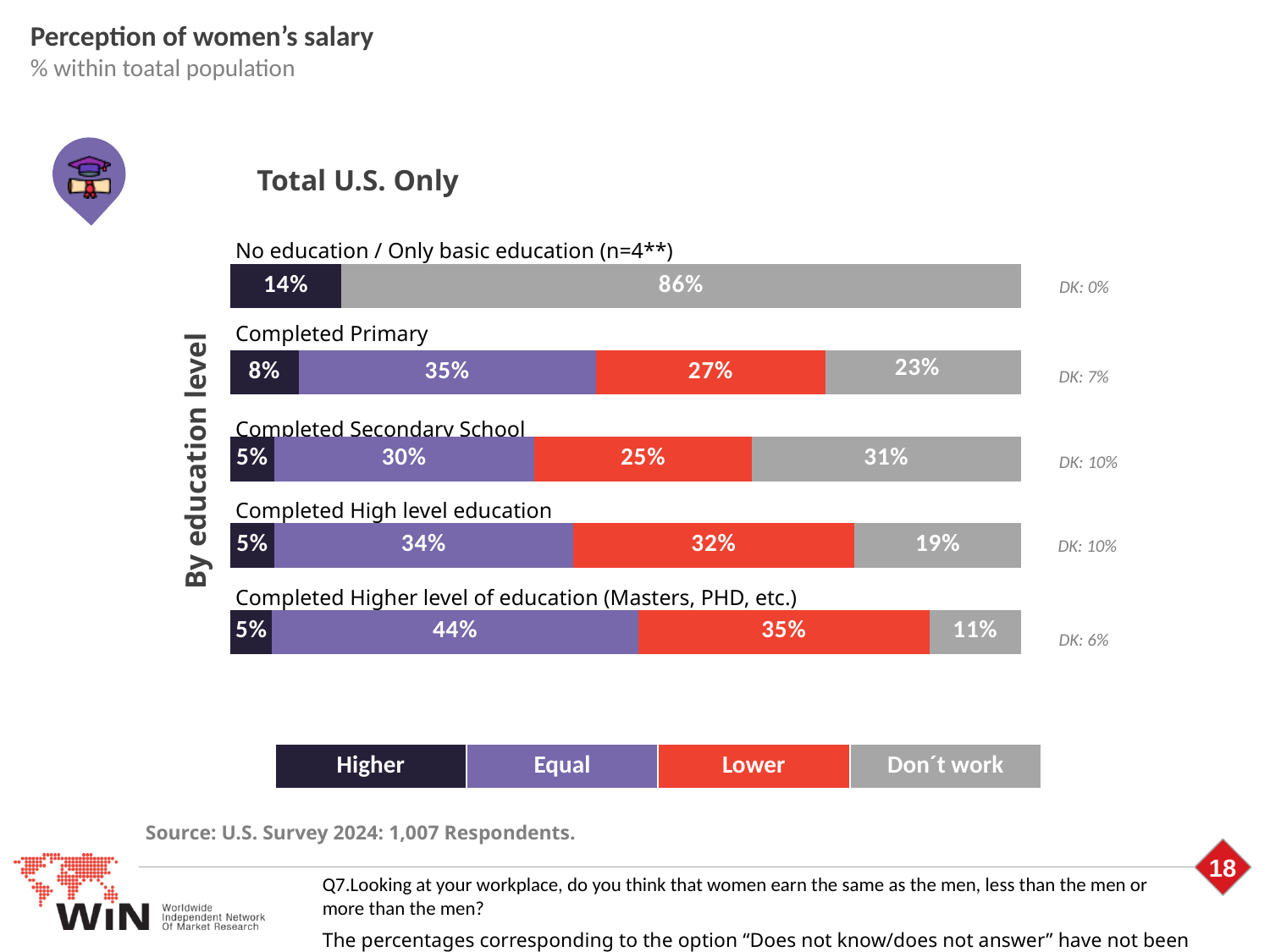
What is the Don't work value for the Completed Secondary School group? 31% What is the Higher value for the No education / Only basic education group? 14% Which education level has the highest Equal value? Completed Higher level of education (Masters, PHD, etc.) What is the Lower value for the Completed Primary group? 27% For the Completed High level education group, which is larger: the Equal value or the Lower value? Equal How many series does the legend list? 4 Which education level has the lowest Don't work value? Completed Higher level of education (Masters, PHD, etc.) What kind of chart is shown on the slide? Stacked bar chart What is the total of the printed values in the Completed Primary bar? 93% What percentage of respondents who completed higher level of education (Masters, PHD, etc.) think women's salary is Equal? 44% How much larger is the Lower value for Completed Higher level of education than for Completed Secondary School? 10 percentage points How many education levels are shown in the chart? 5